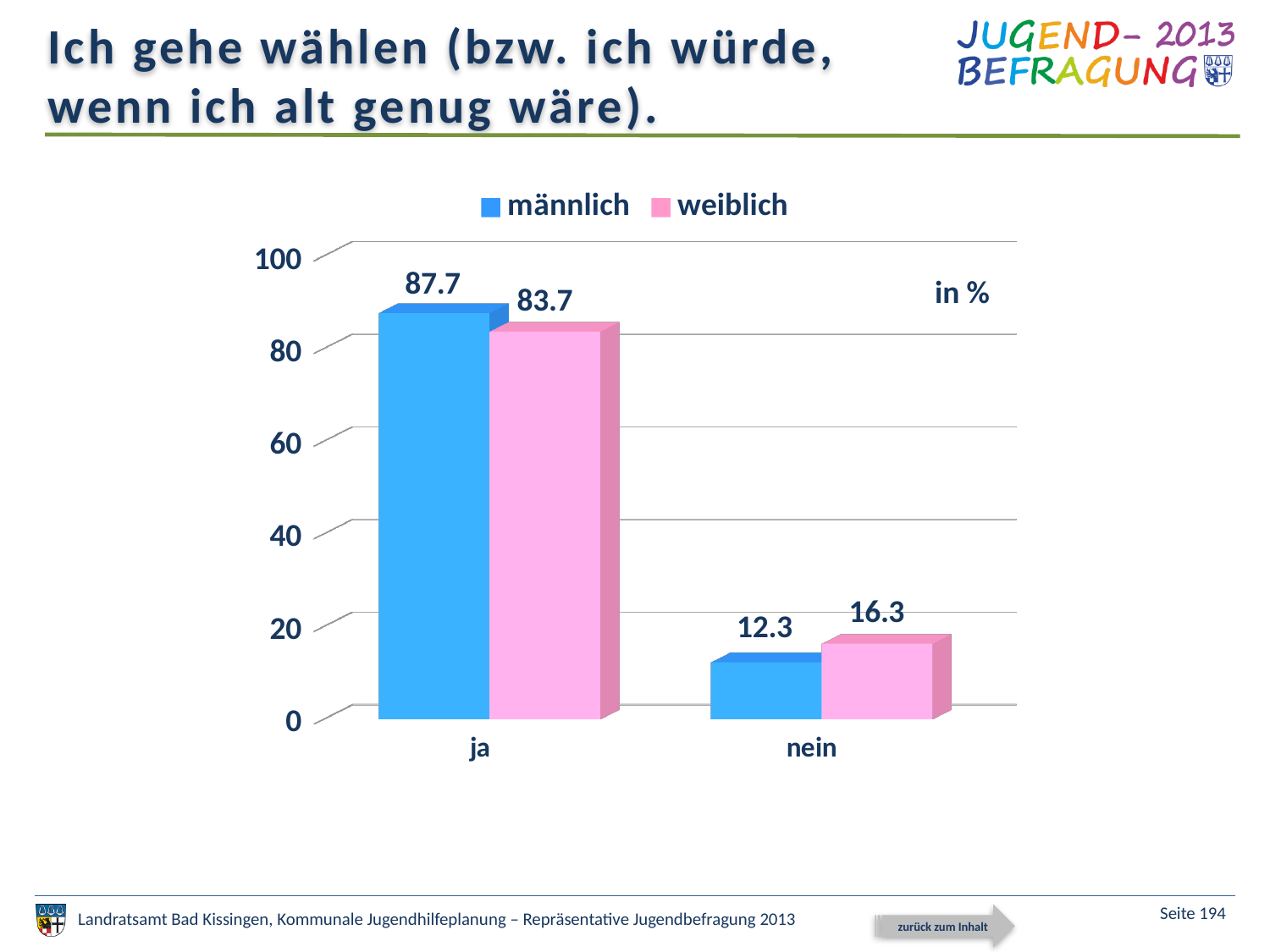
What is the value for männlich in the ja category? 87.7 What is the difference between the männlich and weiblich values in the ja category? 4.0 What is the value for weiblich in the ja category? 83.7 Which series has the higher value in the ja category? männlich What is the difference between the weiblich and männlich values in the nein category? 4.0 How many categories are shown on the x axis? 2 What is the value for weiblich in the nein category? 16.3 Which colour represents the weiblich series? pink How many series does the legend list? 2 What kind of chart is shown on the slide? bar chart Which series has the higher value in the nein category? weiblich What is the value for männlich in the nein category? 12.3